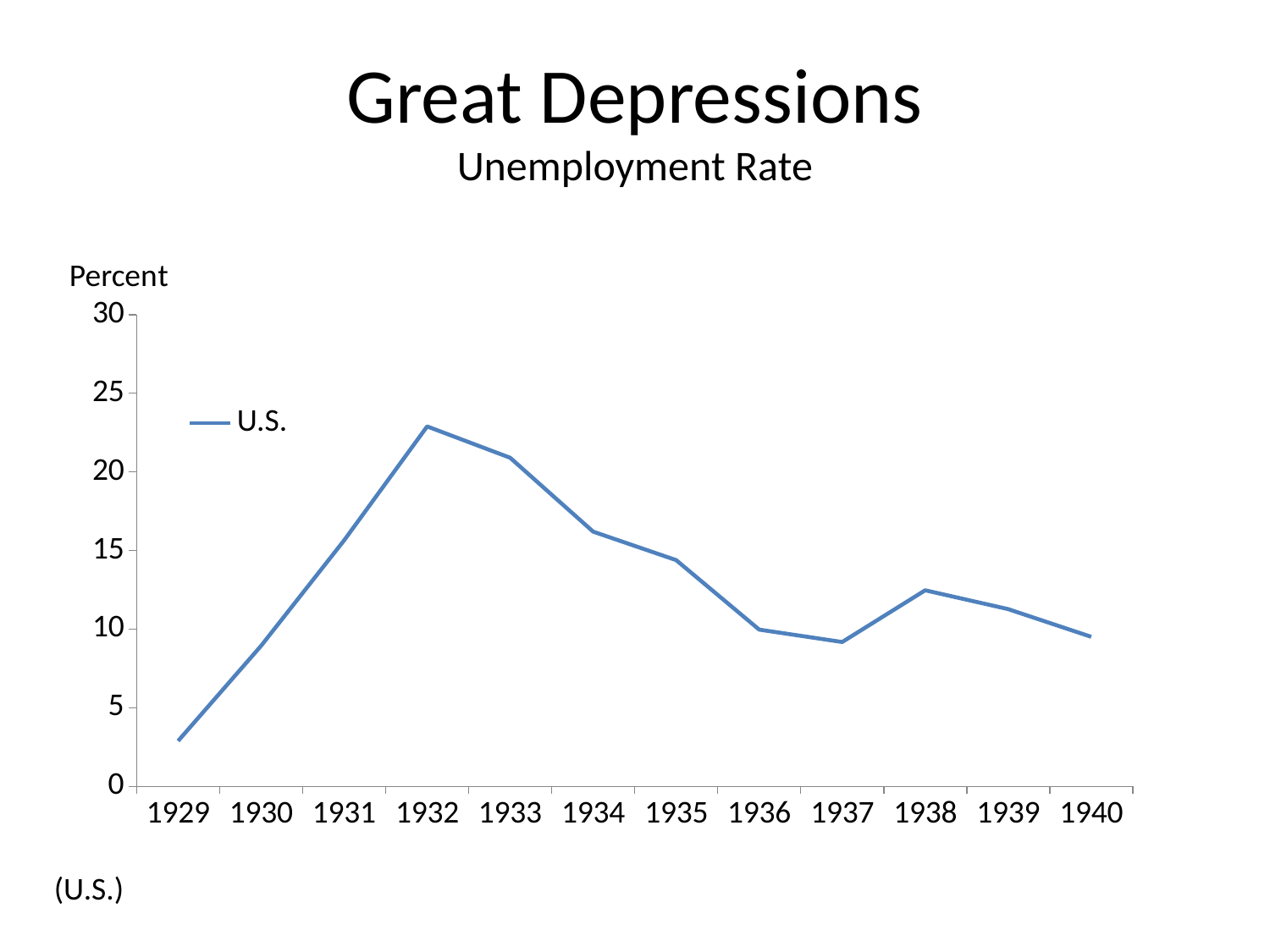
What is the label on the vertical axis of the chart? Percent Which year has a higher U.S. unemployment rate, 1933 or 1935? 1933 What kind of chart is shown on the slide? line chart Is the U.S. unemployment rate in 1929 greater or less than 5? less How many years are plotted along the x axis? 12 In which year is the U.S. unemployment rate highest? 1932 How many series does the legend list? 1 Is the U.S. unemployment rate in 1932 greater or less than 20? greater Is the U.S. unemployment rate in 1937 greater or less than 10? less In which year is the U.S. unemployment rate lowest? 1929 Does the U.S. unemployment rate rise or fall from 1929 to 1932? rise What is the name of the series shown in the legend? U.S.